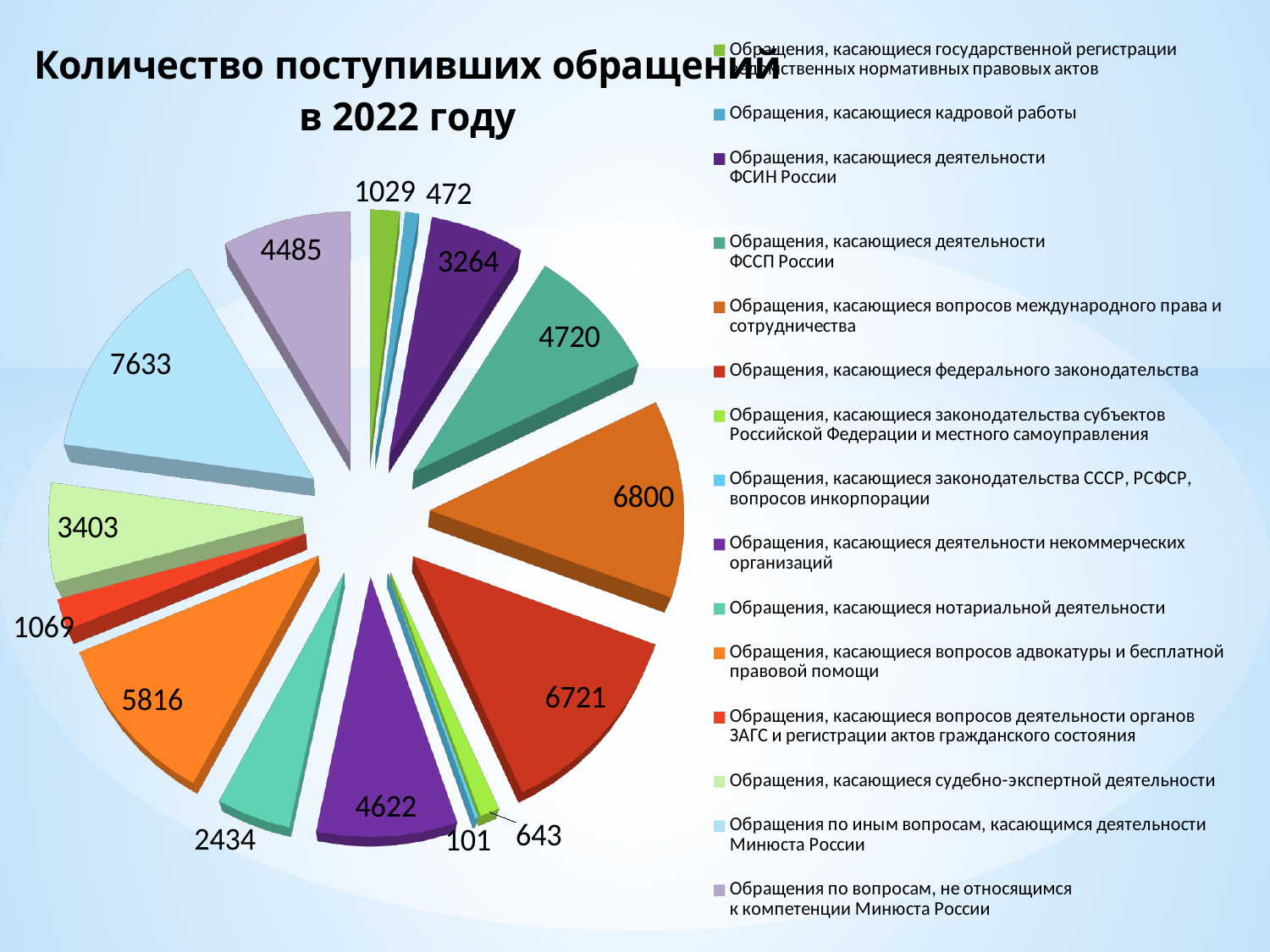
What is the difference between the values for 'Обращения по иным вопросам, касающимся деятельности Минюста России' and 'Обращения по вопросам, не относящимся к компетенции Минюста России'? 3148 Which category has the smallest slice of the pie? Обращения, касающиеся законодательства СССР, РСФСР, вопросов инкорпорации What is the value for 'Обращения по иным вопросам, касающимся деятельности Минюста России'? 7633 How many categories (slices) does the pie chart have? 15 Which is larger: the value for 'Обращения, касающиеся вопросов адвокатуры и бесплатной правовой помощи' or for 'Обращения, касающиеся деятельности некоммерческих организаций'? Обращения, касающиеся вопросов адвокатуры и бесплатной правовой помощи What is the value for 'Обращения, касающиеся вопросов международного права и сотрудничества'? 6800 What is the value for 'Обращения, касающиеся нотариальной деятельности'? 2434 What is the title of the chart? Количество поступивших обращений в 2022 году Which category has the largest slice of the pie? Обращения по иным вопросам, касающимся деятельности Минюста России What kind of chart is shown on the slide? Pie chart What is the difference between the values for 'Обращения, касающиеся вопросов международного права и сотрудничества' and 'Обращения, касающиеся федерального законодательства'? 79 What is the value for 'Обращения, касающиеся деятельности ФСИН России'? 3264